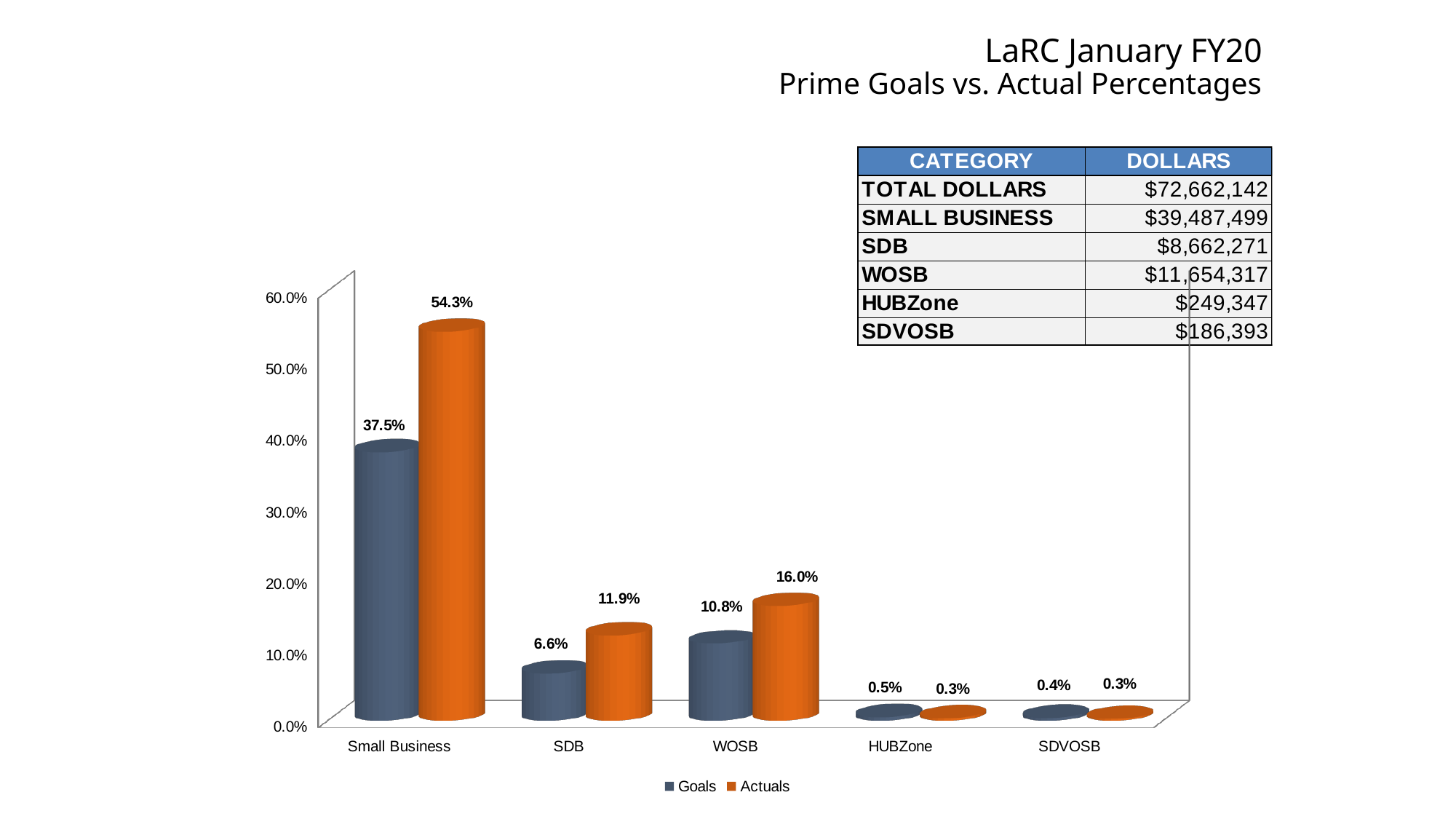
Which category has the highest Actuals value? Small Business What is the Actuals value for Small Business? 54.3% Which category has the lowest Goals value? SDVOSB What is the difference between the Actuals and Goals values for Small Business? 16.8% What kind of chart is shown on the slide? Bar chart What is the Goals value for WOSB? 10.8% Which is larger for HUBZone, the Goals value or the Actuals value? Goals Which colour represents the Actuals series? Orange How many series does the legend list? 2 What is the difference between the Actuals and Goals values for WOSB? 5.2% How many categories are shown on the x axis? 5 What is the Actuals value for SDB? 11.9%